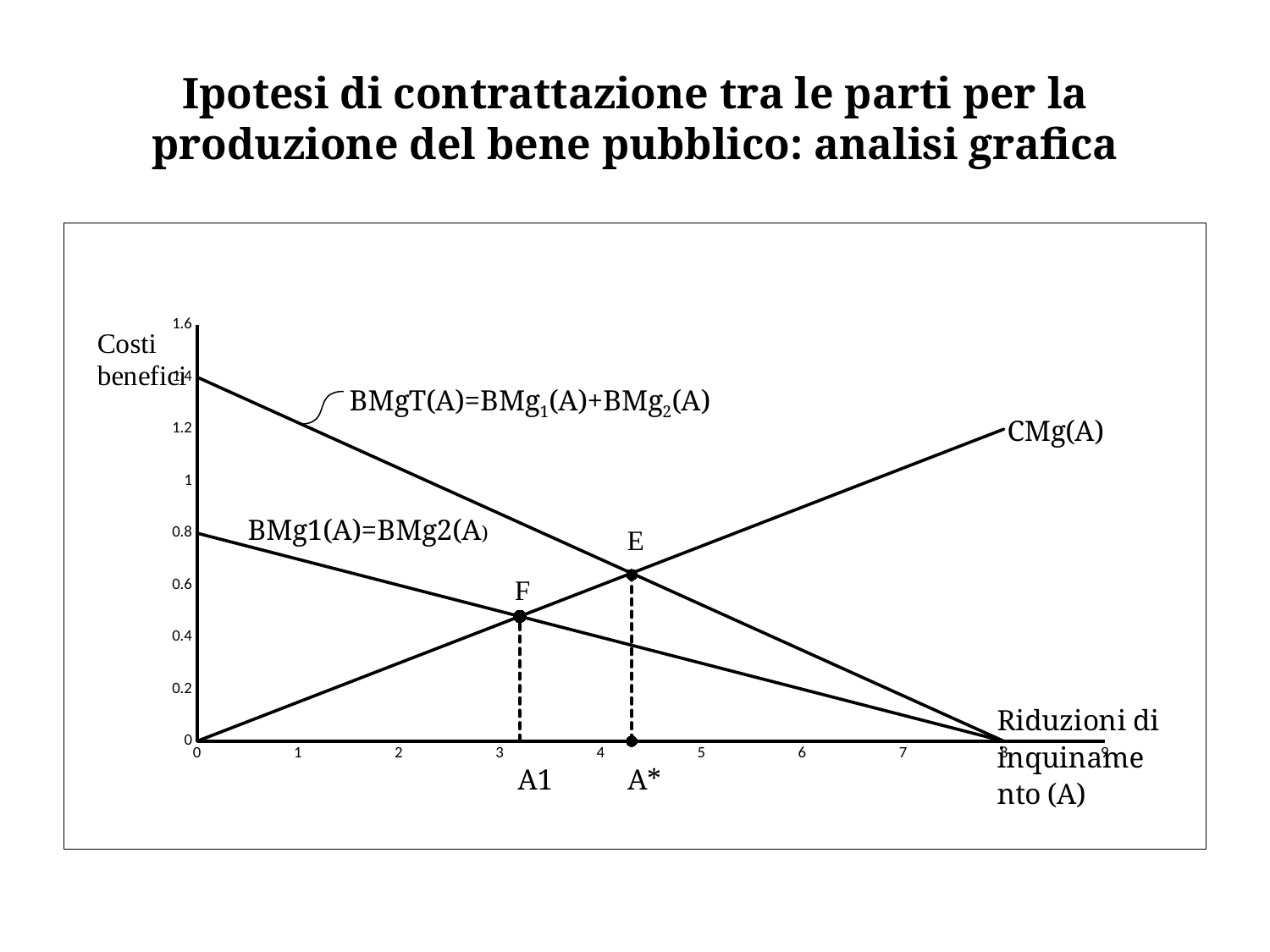
At A = 0, which line is higher, BMgT(A) or BMg1(A)=BMg2(A)? BMgT(A) What kind of chart is shown on the slide? line chart What is the value of BMgT(A) where it meets the vertical axis (at A = 0)? 1.4 What is the label of the horizontal axis? Riduzioni di inquinamento (A) What is the difference between BMgT(A) and BMg1(A) at A = 0? 0.6 Is the vertical value at point F greater or less than 0.6? less What is the value of CMg(A) at A = 0? 0 How many lines are plotted in the chart? 3 Is the vertical value at point E greater or less than 0.8? less Does the CMg(A) line rise or fall as A increases? rises What is the value of BMg1(A)=BMg2(A) at A = 0? 0.8 At which value of A does the BMgT(A) line reach 0 on the horizontal axis? 8